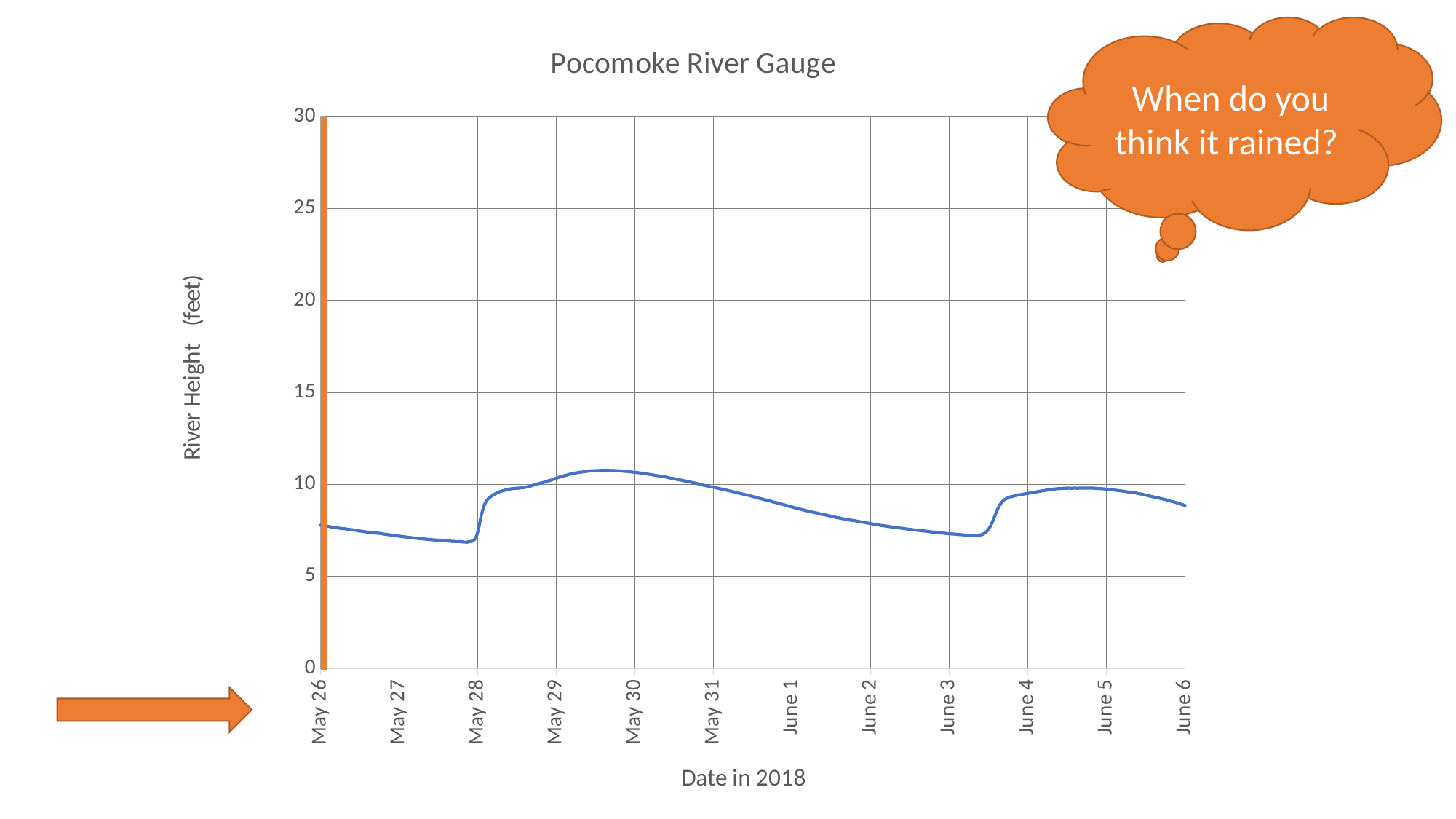
Which date has the higher river height, May 26 or May 30? May 30 Does the river height rise or fall between May 30 and June 3? fall What is the title of the chart? Pocomoke River Gauge Is the river height on June 6 greater or less than 15 feet? less Which date has the higher river height, May 30 or June 3? May 30 Is the river height on May 30 greater or less than 10 feet? greater What is the label of the vertical axis? River Height (feet) Is the river height on May 26 greater or less than 10 feet? less What kind of chart is shown on the slide? line chart How many dates are labelled along the x axis? 12